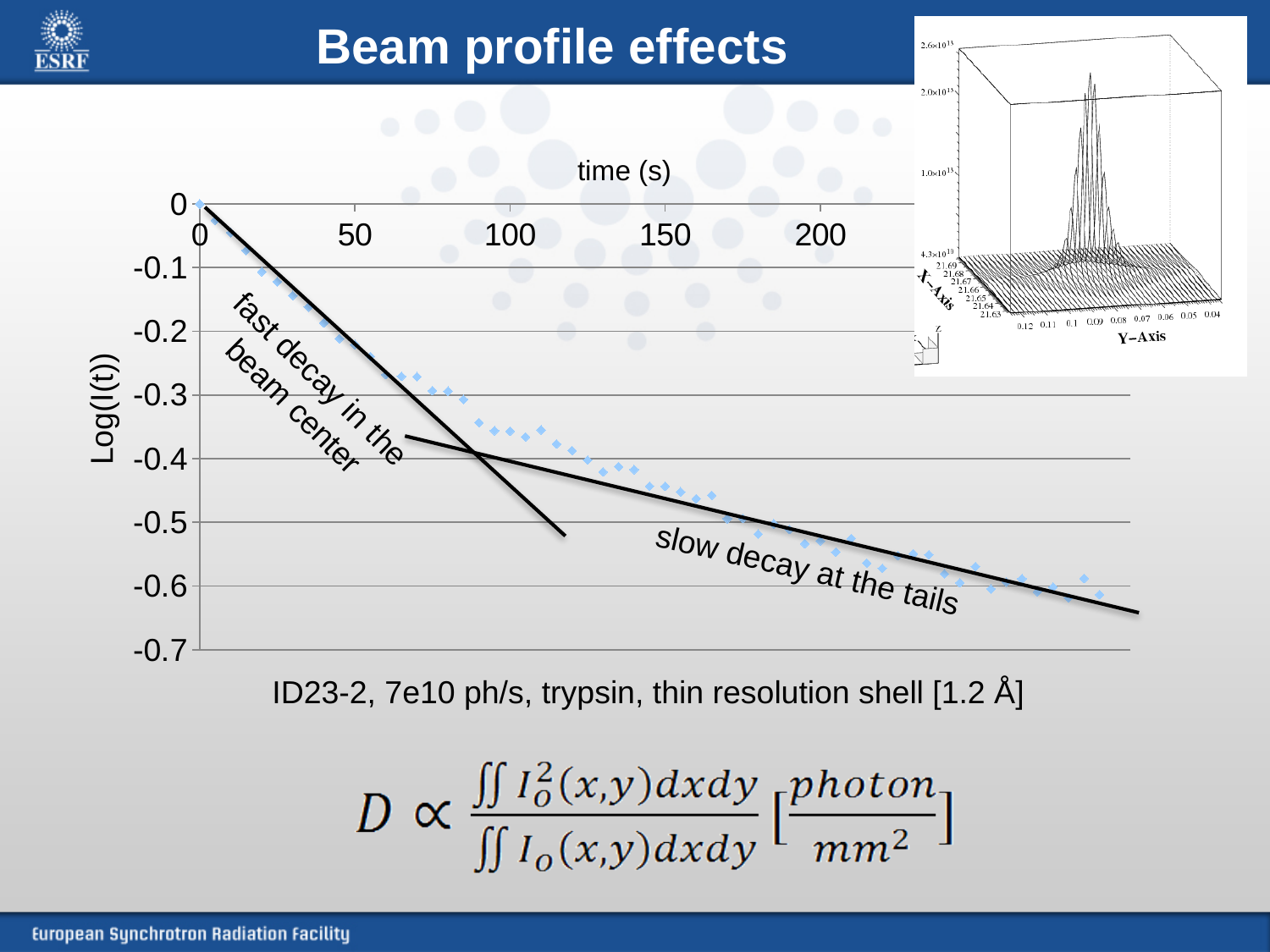
What kind of chart is shown on the slide? scatter chart What is the label of the x axis of the chart? time (s) Which is larger, the value of Log(I(t)) at time 50 or at time 150? time 50 Is the value of Log(I(t)) at time 150 greater or less than -0.5? greater Is the value of Log(I(t)) at time 200 greater or less than -0.5? less What is the value of Log(I(t)) at time 0? 0 Do the plotted values rise or fall as time increases? fall What is the label of the y axis of the chart? Log(I(t)) Is the value of Log(I(t)) at time 100 greater or less than -0.3? less What is the lowest value shown on the y axis of the chart? -0.7 At which time is the plotted value highest? 0